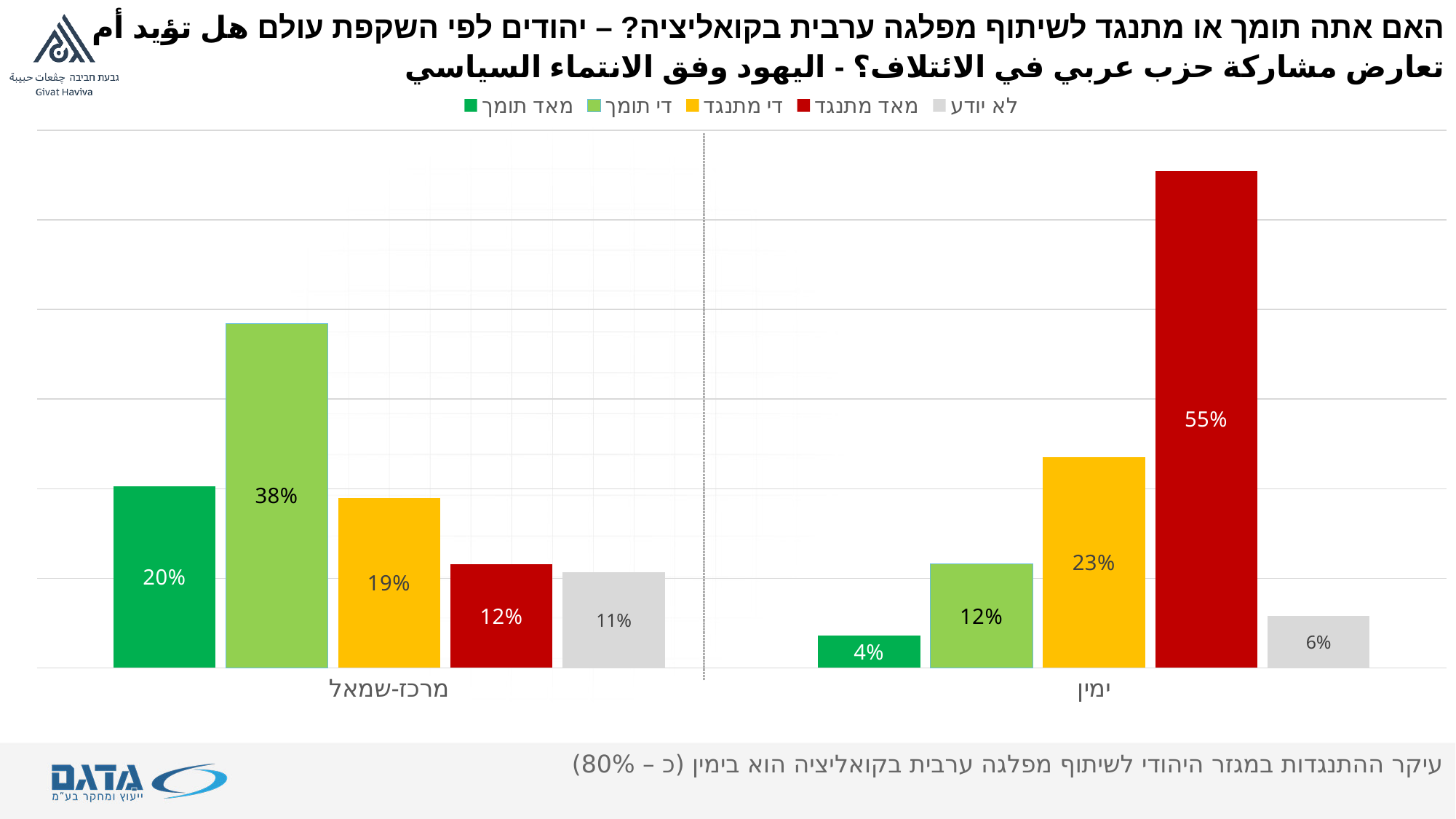
Which is larger: די מתנגד for ימין or די מתנגד for מרכז-שמאל? ימין What is the value for לא יודע in the ימין category? 6% What is the value for מאד מתנגד in the ימין category? 55% How many categories are shown on the x axis? 2 What is the value for מאד תומך in the מרכז-שמאל category? 20% What kind of chart is shown on the slide? Bar chart Which series has the highest value in the מרכז-שמאל category? די תומך What is the value for די תומך in the מרכז-שמאל category? 38% What is the difference between the מאד מתנגד values for ימין and מרכז-שמאל? 43% How many series does the legend list? 5 Which series has the lowest value in the ימין category? מאד תומך Which series has the highest value in the ימין category? מאד מתנגד